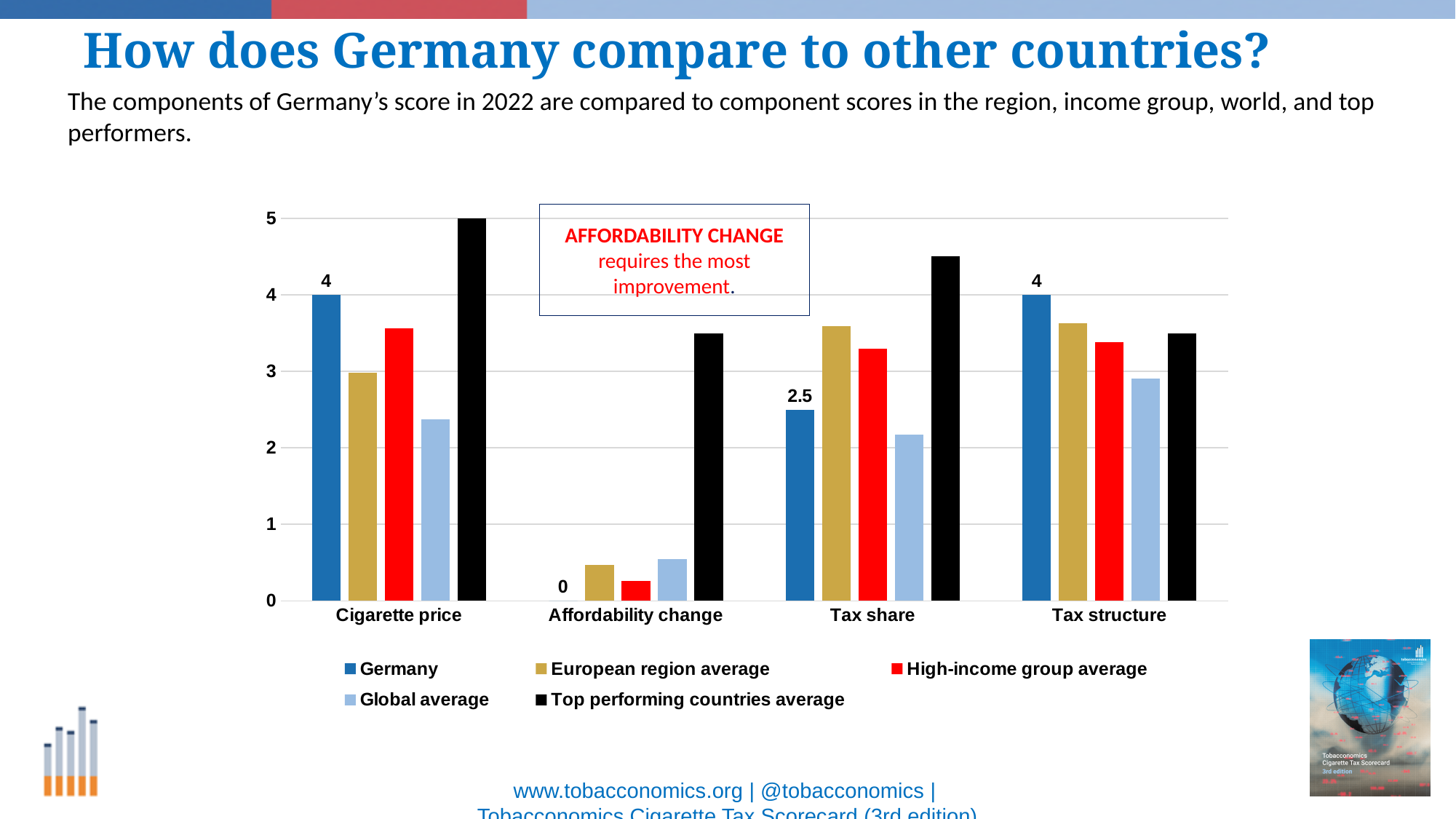
What is Germany's score for Cigarette price? 4 What kind of chart is shown on the slide? Bar chart How many component categories are shown on the x axis? 4 What is Germany's score for Tax share? 2.5 In which component does Germany have its lowest score? Affordability change What is the difference between Germany's Cigarette price score and its Tax share score? 1.5 What is Germany's score for Affordability change? 0 What is Germany's score for Tax structure? 4 For Tax share, which is larger: Germany or the European region average? European region average How many series does the legend list? 5 Is the Top performing countries average for Tax share greater or less than 4? greater Is the Global average for Cigarette price greater or less than 3? less